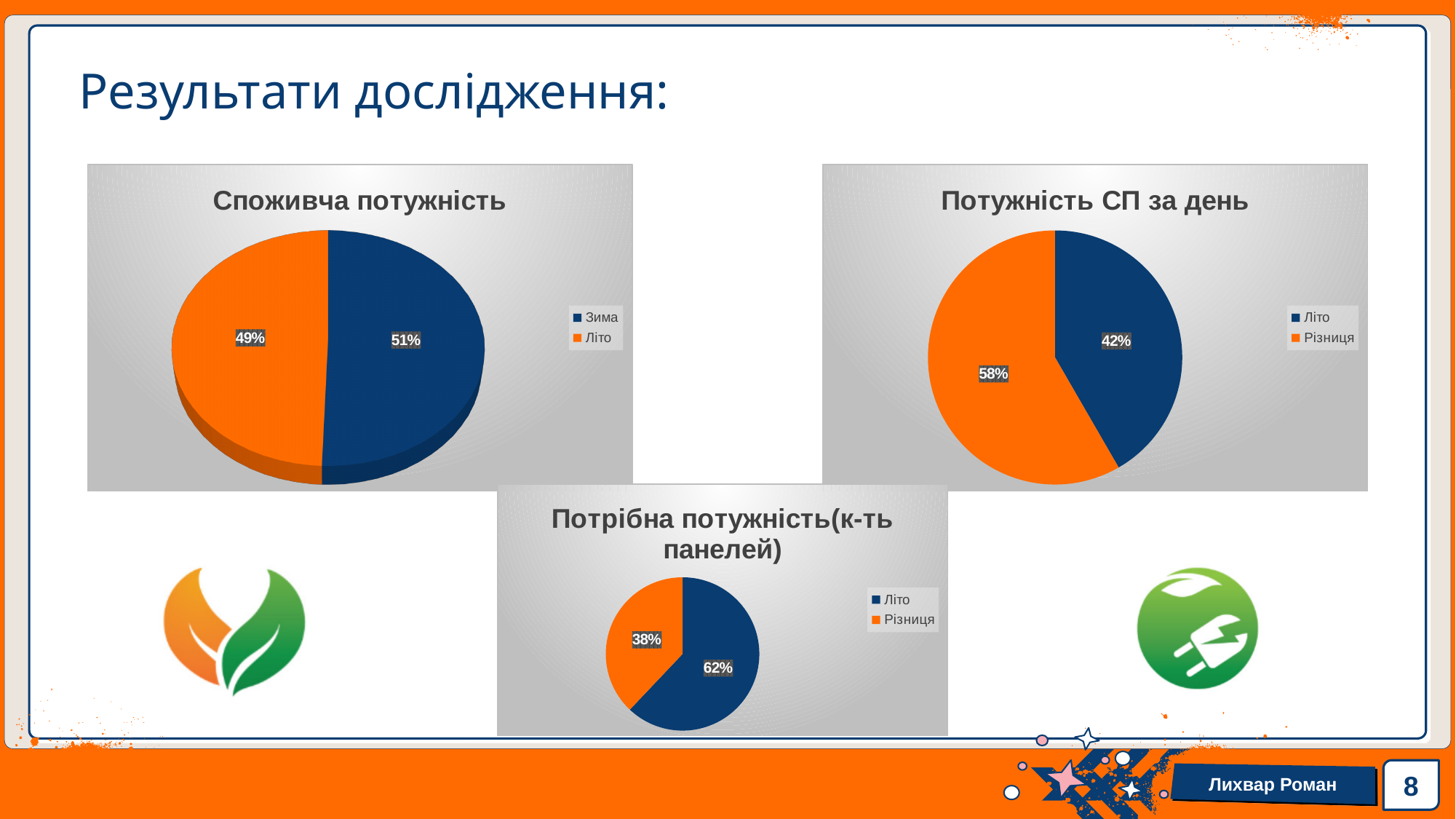
In the chart titled "Потрібна потужність(к-ть панелей)", what share does "Різниця" have? 38% In the chart titled "Потужність СП за день", what is the difference between the "Різниця" and "Літо" shares? 16% How many entries does the legend of the chart titled "Споживча потужність" list? 2 In the chart titled "Потужність СП за день", which slice is the largest? Різниця In the chart titled "Споживча потужність", what share does "Літо" have? 49% In the chart titled "Потрібна потужність(к-ть панелей)", what share does "Літо" have? 62% In the chart titled "Споживча потужність", which slice is larger, "Зима" or "Літо"? Зима What kind of chart is the one titled "Потужність СП за день"? Pie chart In the chart titled "Потрібна потужність(к-ть панелей)", which slice is the smallest? Різниця